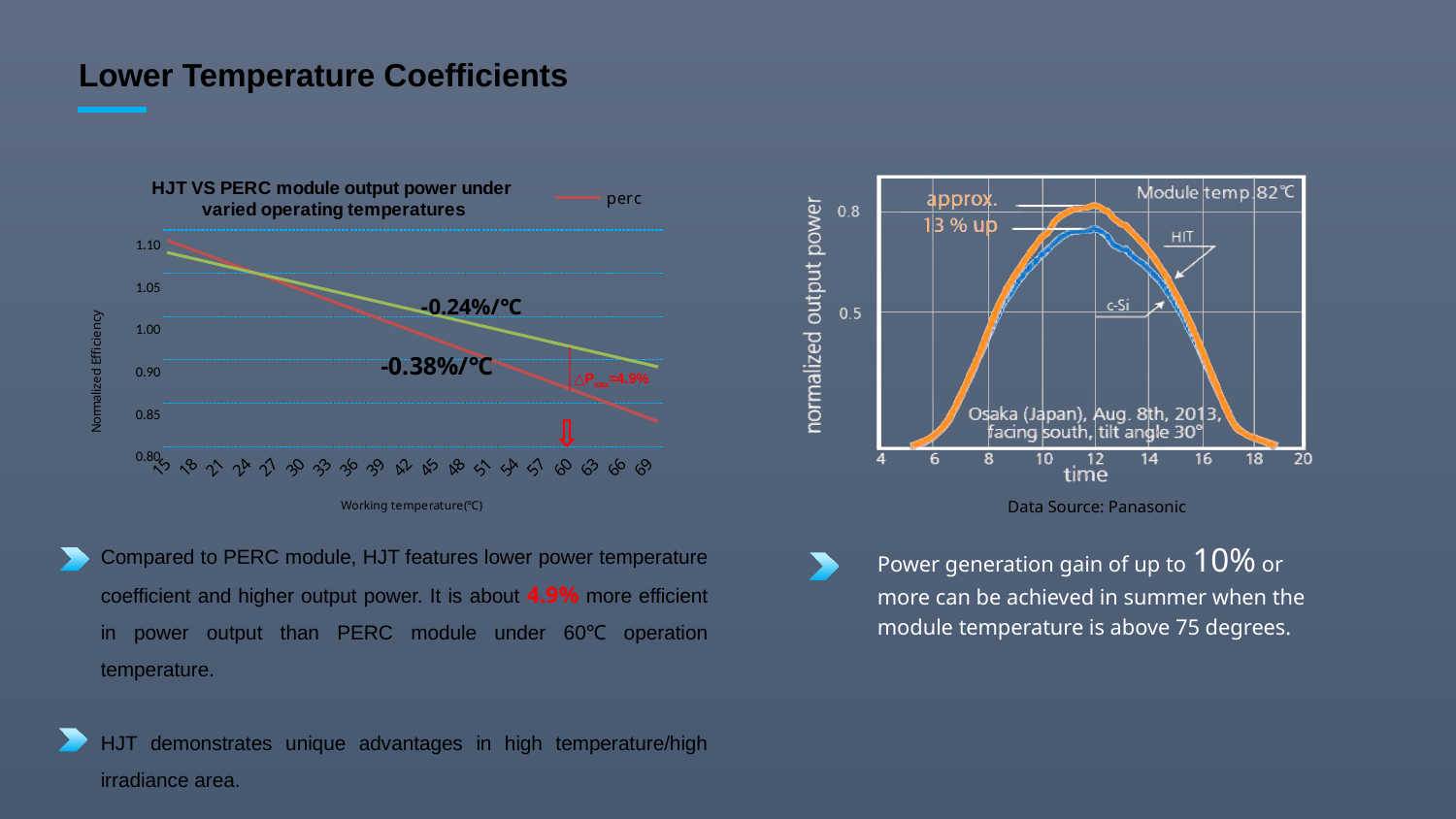
In the left chart, what is the label of the x axis? Working temperature(℃) In the left chart, what is the annotated ΔPmax between the two lines at 60℃? 4.9% In the right chart, is the peak normalized output power of the c-Si curve greater or less than 0.8? less In the left chart, do the normalized efficiency values rise or fall as working temperature increases? fall What is the data source given for the right chart? Panasonic In the left chart, at 60℃, which line has the higher normalized efficiency, the green HJT line or the red perc line? green HJT line What kind of chart is the left chart titled 'HJT VS PERC module output power under varied operating temperatures'? line chart In the left chart, what temperature coefficient is annotated on the green (HJT) line? -0.24%/℃ In the left chart, what temperature coefficient is annotated on the red (perc) line? -0.38%/℃ In the right chart, at time 12, which curve has the higher normalized output power, HIT or c-Si? HIT In the left chart, how many working temperature categories are shown on the x axis? 19